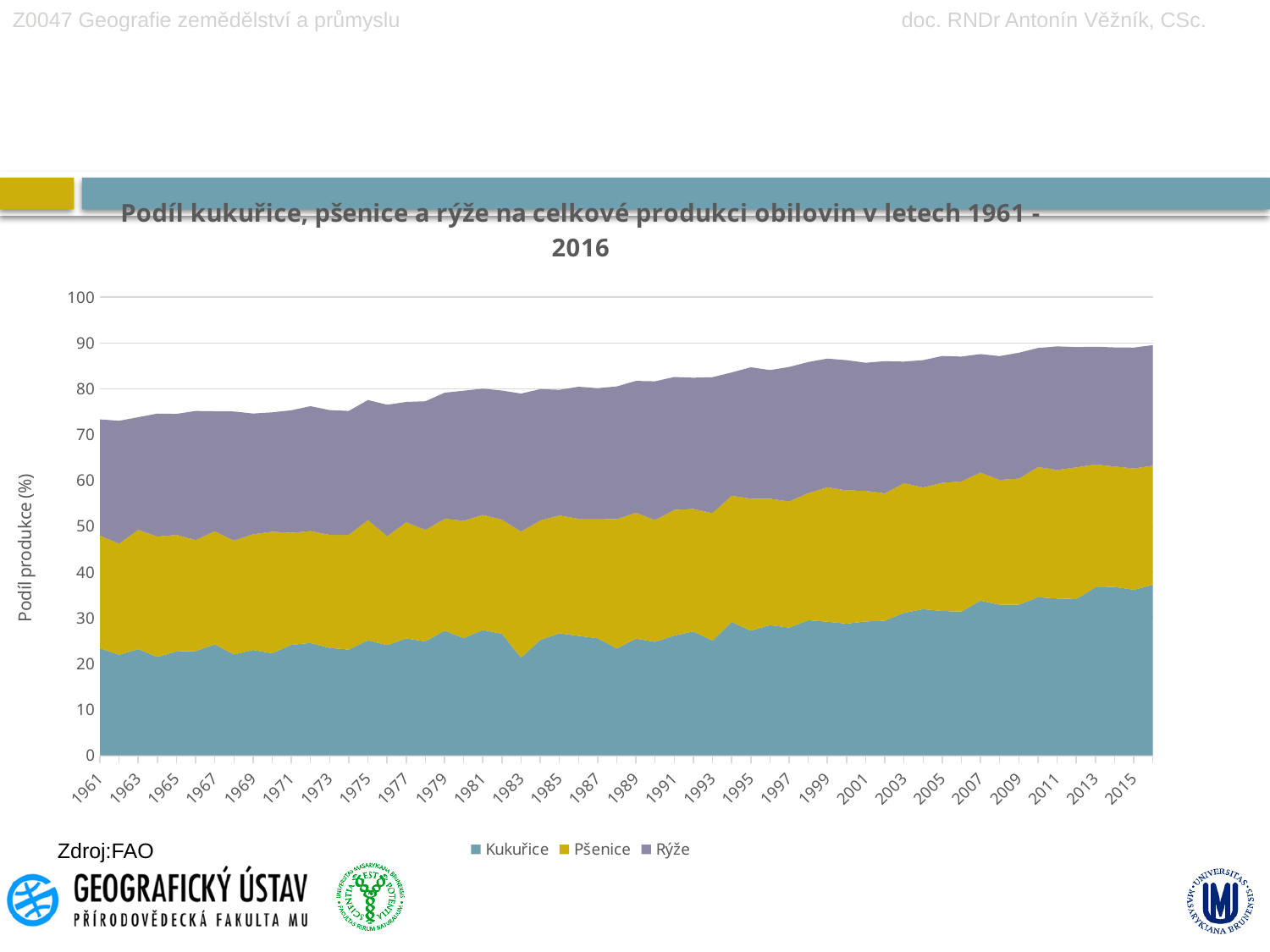
What is the label of the vertical axis? Podíl produkce (%) What kind of chart is shown on the slide? Stacked area chart Is the value for Kukuřice in 1961 greater or less than 30? less Which three series are listed in the legend? Kukuřice, Pšenice, Rýže Is the value for Kukuřice in 2015 greater or less than 30? greater Is the combined share of Kukuřice and Pšenice in 2015 greater or less than 50? greater Which series is plotted at the bottom of the stack? Kukuřice Does the combined share of the three crops rise or fall from 1961 to 2016? Rises How many series does the legend list? 3 Does the share of Kukuřice generally rise or fall over the period shown? Rises